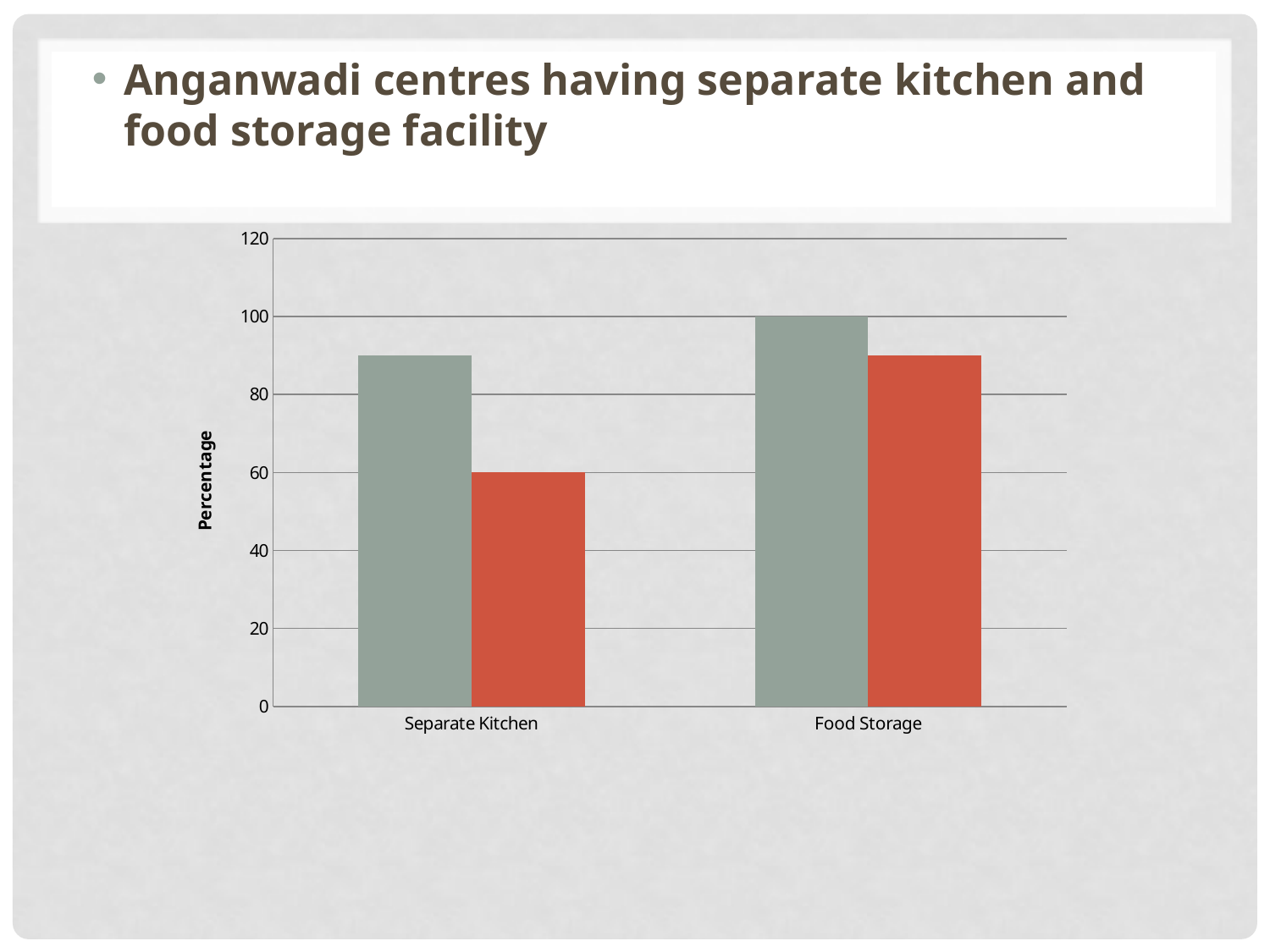
What is the label on the vertical axis of the chart? Percentage Is the value of the grey bar for Separate Kitchen greater or less than 80? greater Is the value of the red bar for Food Storage greater or less than 80? greater What is the value of the red bar for Separate Kitchen? 60 What is the value of the grey bar for Food Storage? 100 How many categories are shown on the x axis of the chart? 2 Do the red bars rise or fall from Separate Kitchen to Food Storage? rise Which category has the taller grey bar, Separate Kitchen or Food Storage? Food Storage For Separate Kitchen, which bar is taller, the grey bar or the red bar? the grey bar Which category has the taller red bar, Separate Kitchen or Food Storage? Food Storage Is the value of the red bar for Separate Kitchen greater or less than 80? less What kind of chart is shown on the slide? bar chart